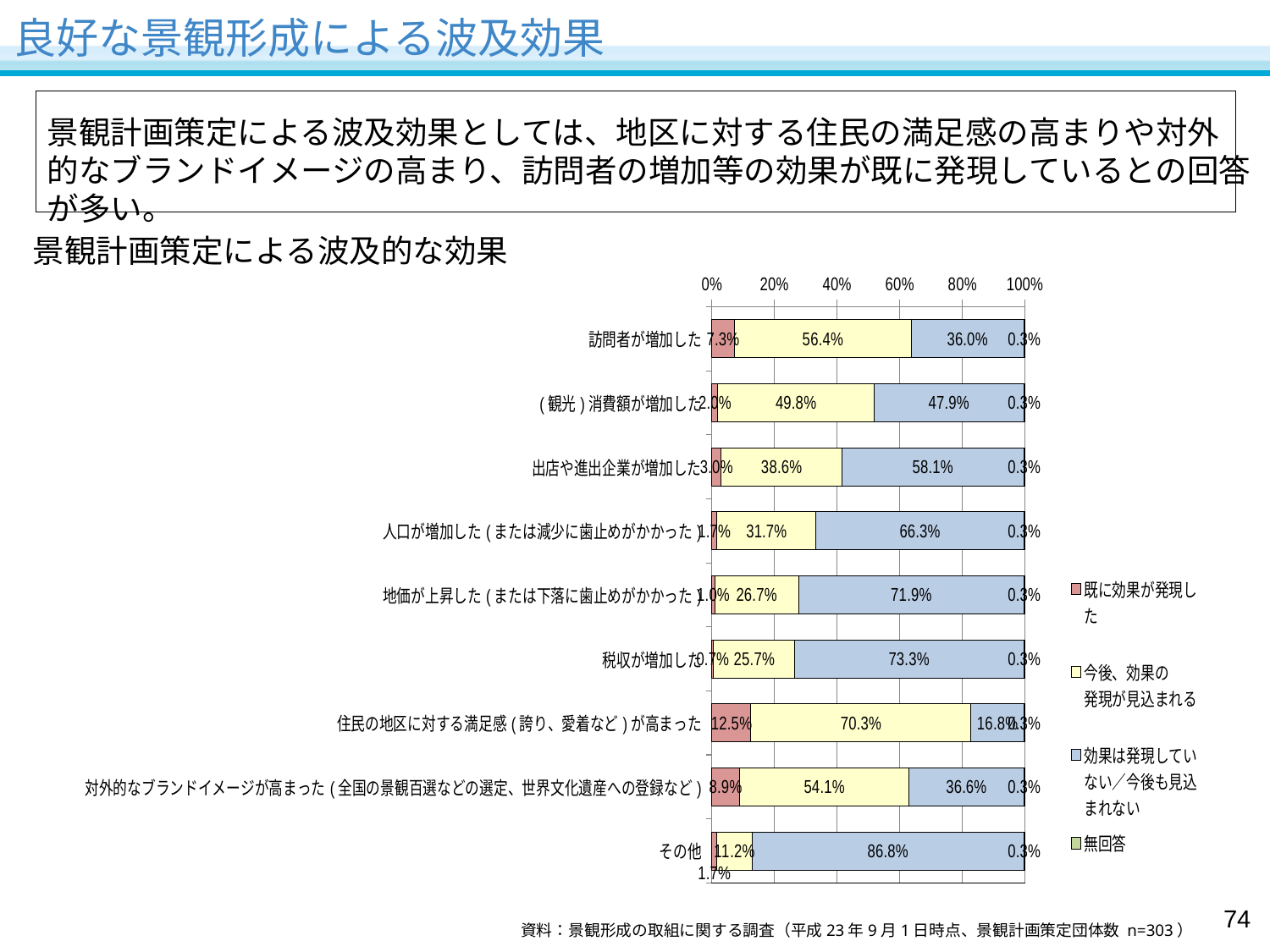
What is the value of 効果は発現していない／今後も見込まれない for 税収が増加した? 73.3% Which category has the highest value for 効果は発現していない／今後も見込まれない? その他 What type of chart is shown on the slide? Stacked bar chart What is the value of 無回答 for 人口が増加した（または減少に歯止めがかかった）? 0.3% Which is larger for 対外的なブランドイメージが高まった: 今後、効果の発現が見込まれる or 効果は発現していない／今後も見込まれない? 今後、効果の発現が見込まれる What is the value of 今後、効果の発現が見込まれる for 訪問者が増加した? 56.4% How many categories are plotted on the chart? 9 What is the value of 既に効果が発現した for 住民の地区に対する満足感（誇り、愛着など）が高まった? 12.5% What is the difference between the 今後、効果の発現が見込まれる values for 住民の地区に対する満足感（誇り、愛着など）が高まった and 訪問者が増加した? 13.9% Which category has the highest value for 既に効果が発現した? 住民の地区に対する満足感（誇り、愛着など）が高まった How many series does the legend list? 4 What is the value of 効果は発現していない／今後も見込まれない for その他? 86.8%